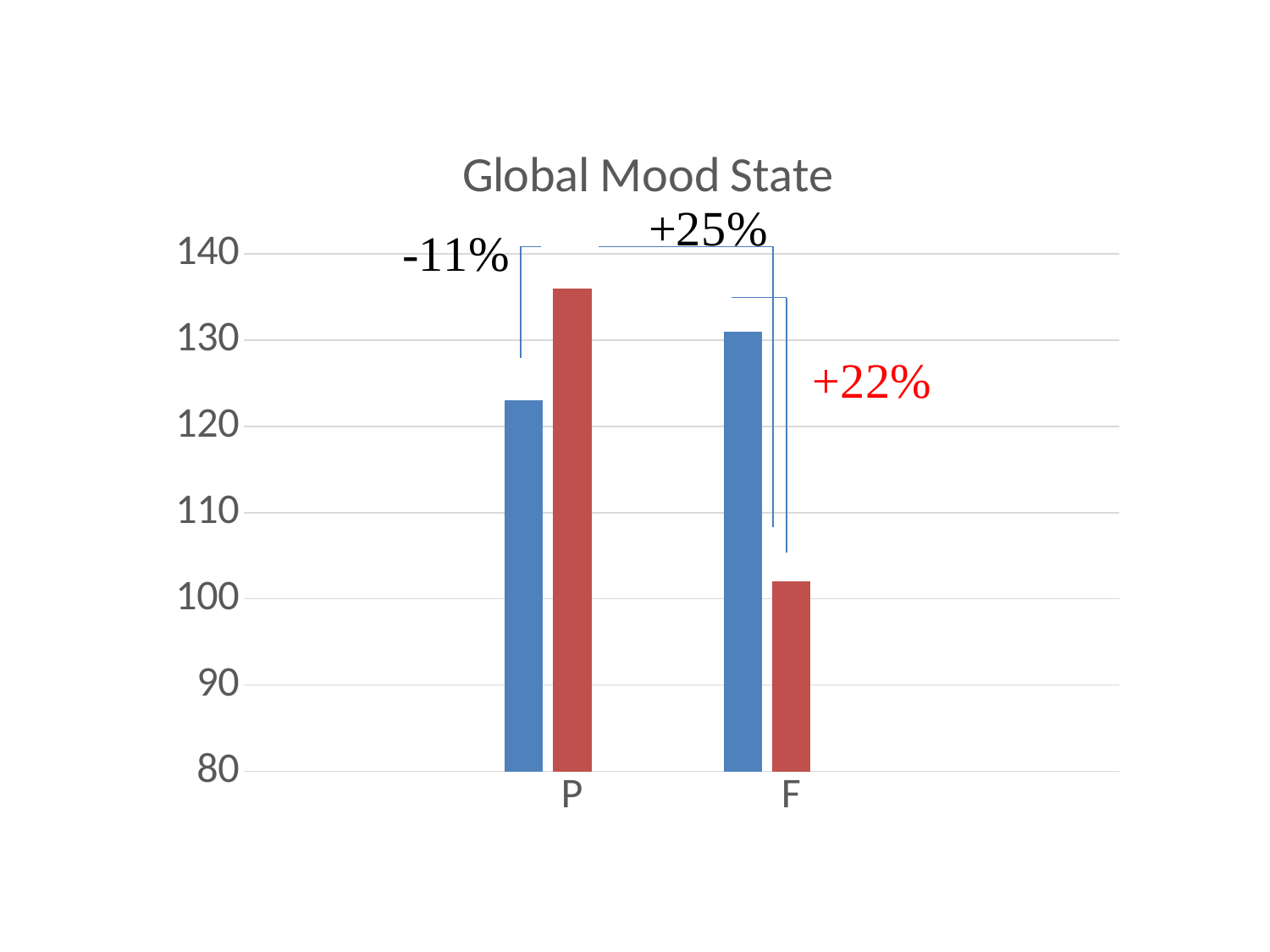
For category F, which bar is taller, the blue bar or the red bar? the blue bar Is the red bar for F greater or less than 110? less Is the red bar for P greater or less than 130? greater For category P, which bar is taller, the blue bar or the red bar? the red bar What is the title of the chart? Global Mood State How many categories are shown on the x axis of the chart? 2 Which bar is the shortest in the chart? the red bar for F What kind of chart is shown on the slide? bar chart Is the blue bar for F greater or less than 120? greater What percentage change is written in red on the chart? +22% Which bar is the tallest in the chart? the red bar for P